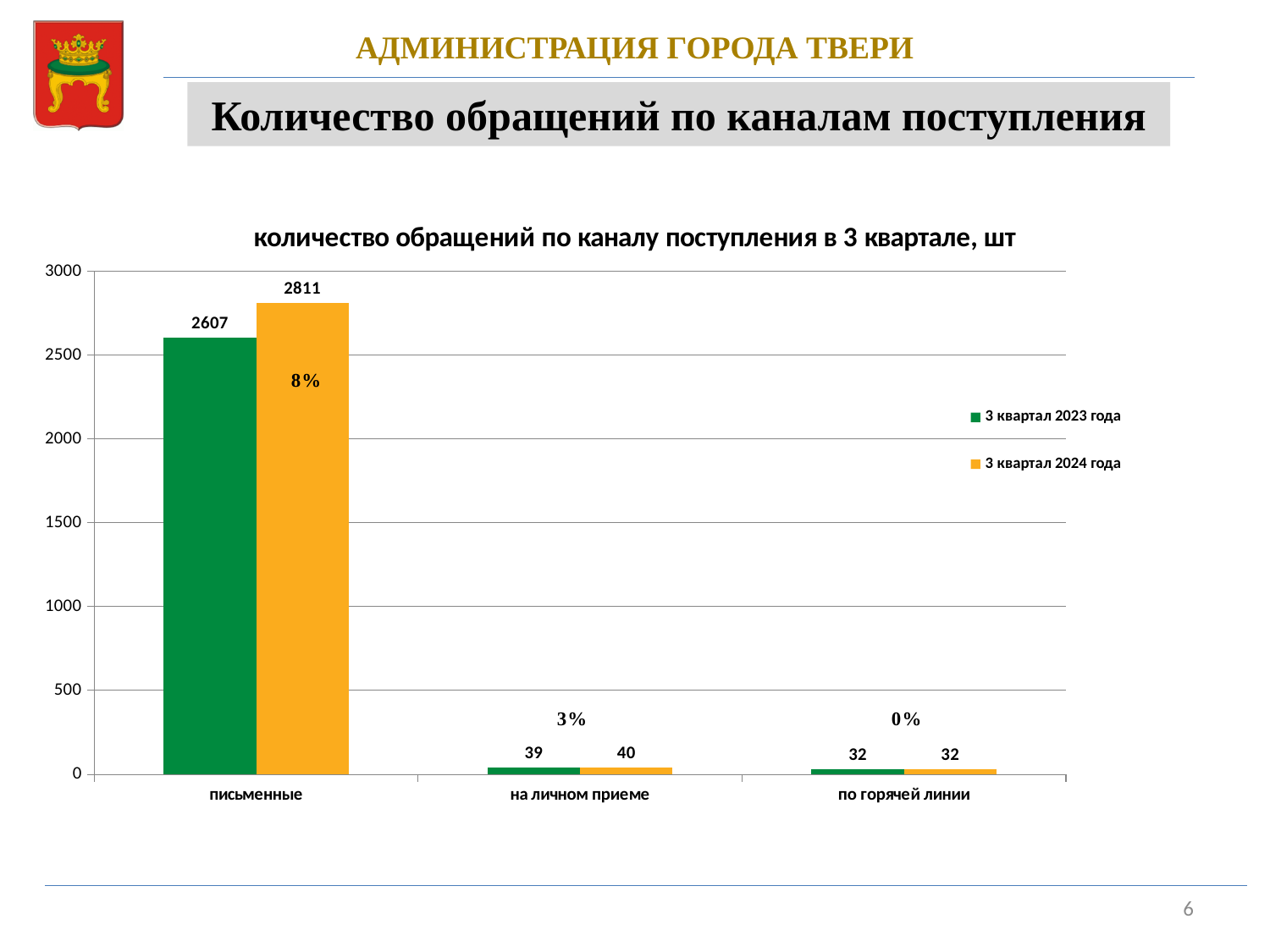
What is the value for письменные in the 3 квартал 2024 года series? 2811 Is the value for письменные in 3 квартал 2023 года greater or less than 2500? greater How many series does the legend list? 2 Which category has the highest value in the 3 квартал 2024 года series? письменные What is the value for на личном приеме in the 3 квартал 2024 года series? 40 What is the value for по горячей линии in the 3 квартал 2023 года series? 32 Which category has the lowest value in the 3 квартал 2023 года series? по горячей линии What kind of chart is shown on the slide? bar chart Which is larger for на личном приеме: the 3 квартал 2023 года value or the 3 квартал 2024 года value? 3 квартал 2024 года What is the difference between the 3 квартал 2024 года and 3 квартал 2023 года values for письменные? 204 How many categories are shown on the x axis? 3 What is the value for письменные in the 3 квартал 2023 года series? 2607